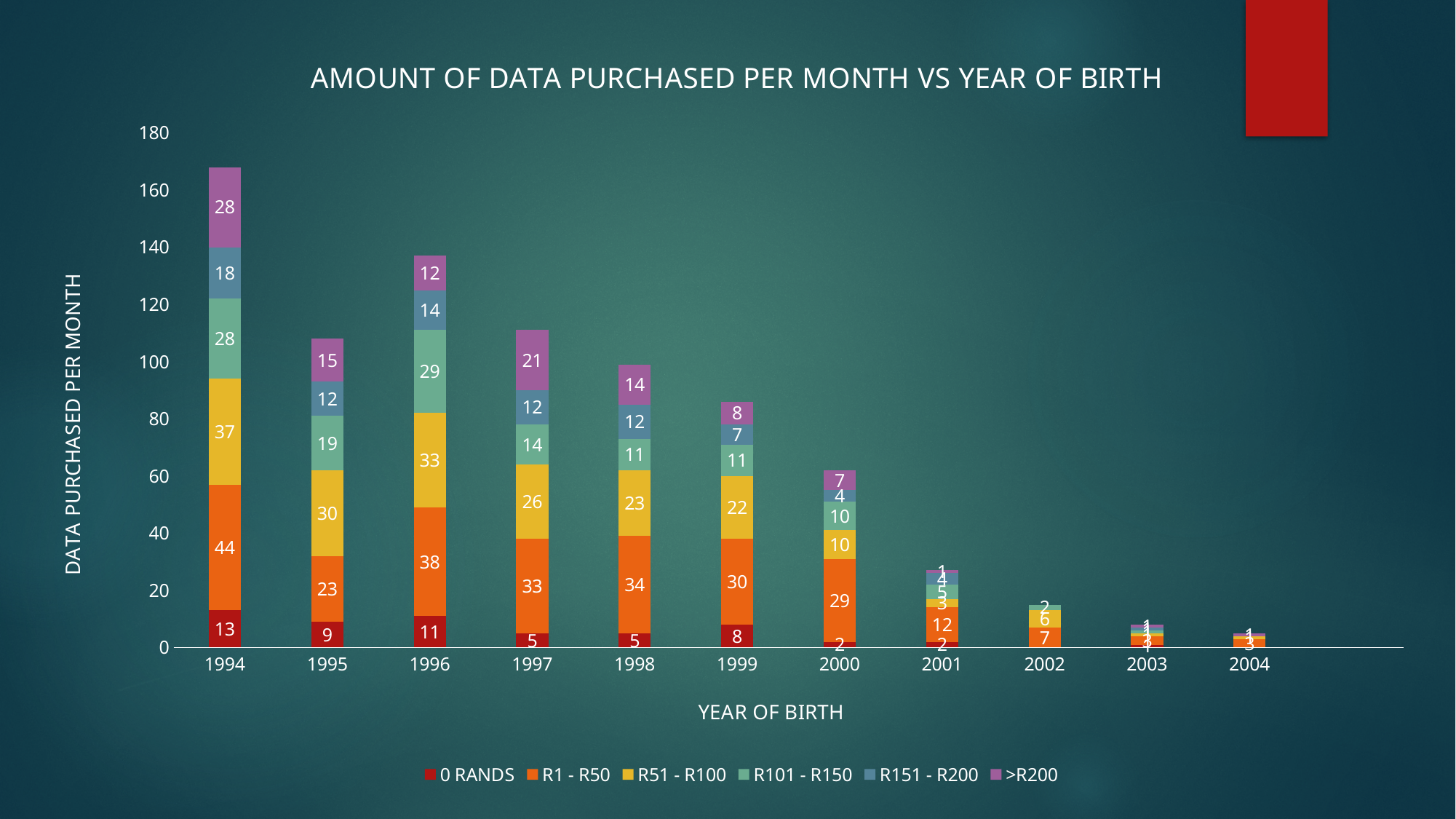
Which year of birth has the tallest stacked bar overall? 1994 What is the value of the R101 - R150 segment for 1996? 29 Is the total stacked bar for 2000 greater or less than 80? less How many series does the legend list? 6 What is the value of the >R200 segment for 1997? 21 What is the value of the R1 - R50 segment for 1994? 44 Which is larger, the R1 - R50 value for 1998 or for 1999? 1998 What is the difference between the R51 - R100 values for 1994 and 1995? 7 How many years of birth are shown on the x axis? 11 What is the value of the 0 RANDS segment for 1999? 8 What is the total of the stacked bar for 1994? 168 What type of chart is shown on the slide? Stacked bar chart